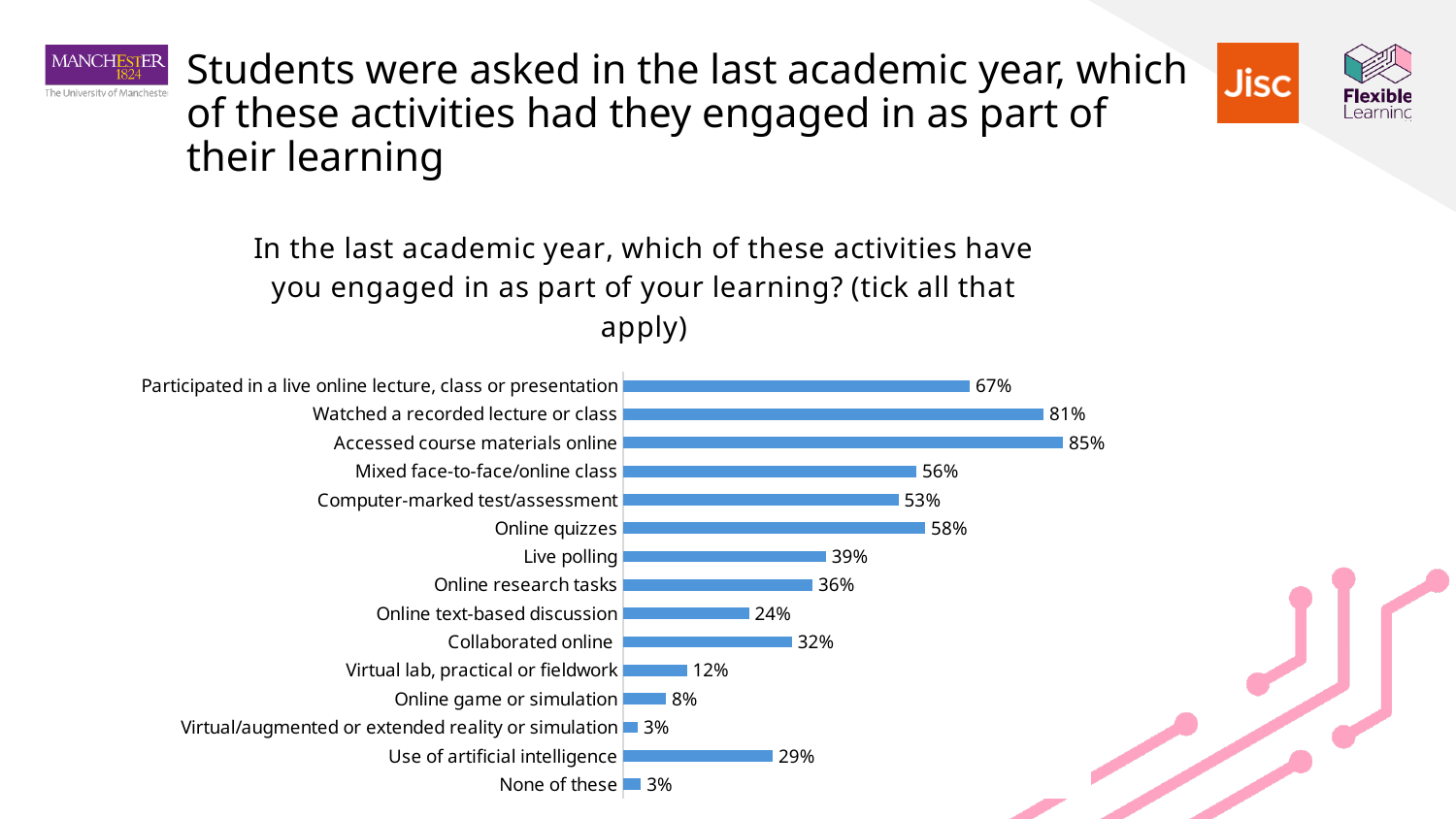
Which has a higher value: 'Live polling' or 'Online research tasks'? Live polling What is the difference between the percentage for 'Watched a recorded lecture or class' and 'Participated in a live online lecture, class or presentation'? 14% Which is larger: 'Collaborated online' or 'Online text-based discussion'? Collaborated online What is the value shown for 'Use of artificial intelligence'? 29% What type of chart is shown on the slide? Bar chart How many activity categories are shown in the chart? 15 What is the value for 'Online game or simulation'? 8% What is the value shown for 'None of these'? 3% What percentage of students reported participating in a live online lecture, class or presentation? 67% What percentage of students said they accessed course materials online? 85% Which activity has the highest percentage of students engaging in it? Accessed course materials online What is the difference between the values for 'Online quizzes' and 'Computer-marked test/assessment'? 5%